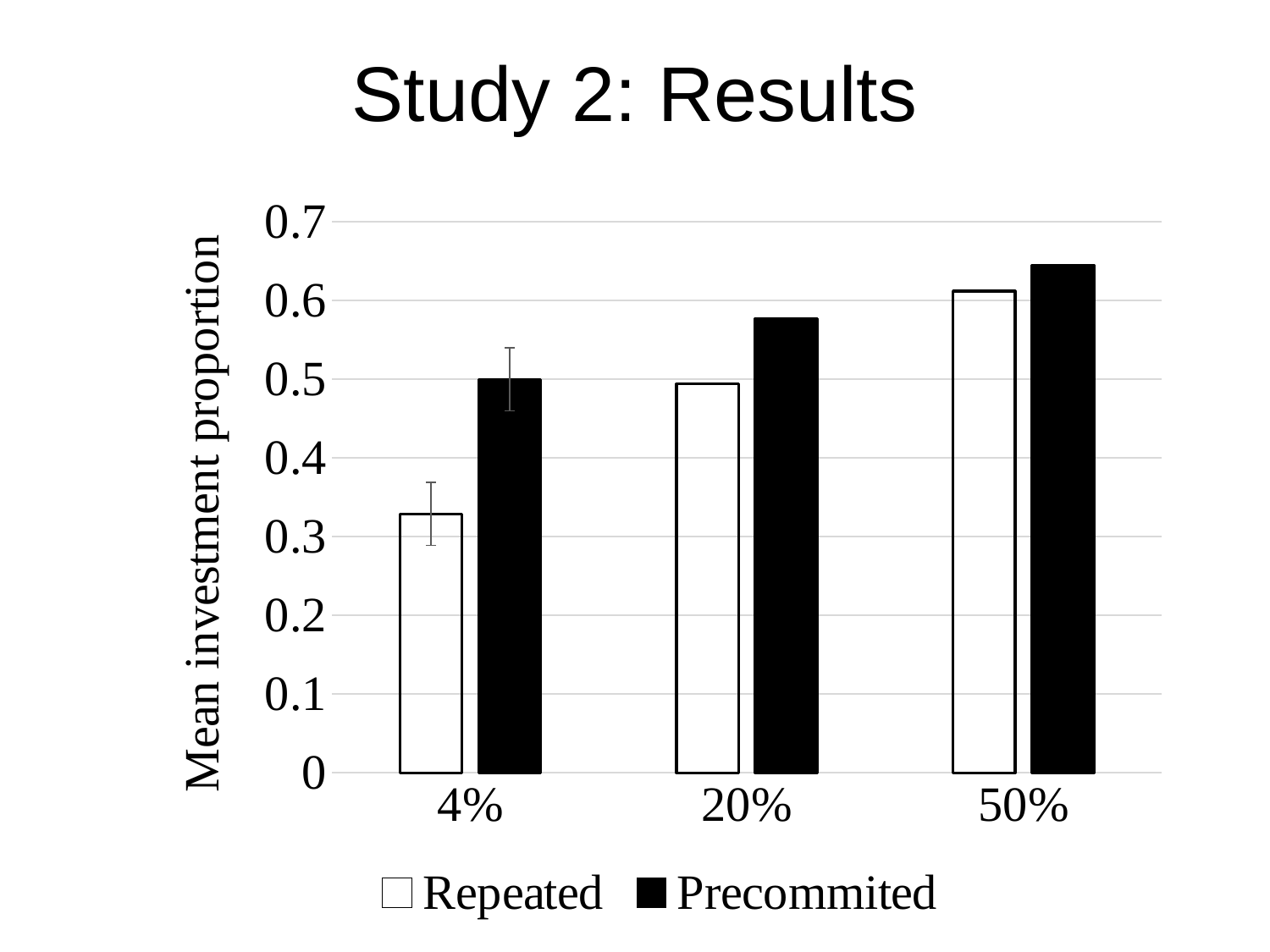
Is the value for Precommited at 20% greater or less than 0.5? greater Which category and series has the lowest mean investment proportion? Repeated at 4% What is the title of the y axis? Mean investment proportion Is the value for Repeated at 4% greater or less than 0.4? less Do the Repeated values rise or fall as the x-axis moves from 4% to 50%? rise Is the value for Precommited at 50% greater or less than 0.6? greater How many series does the legend list? 2 What kind of chart is shown on the slide? bar chart Which category and series has the highest mean investment proportion? Precommited at 50% At 20%, which series has the larger value, Repeated or Precommited? Precommited How many categories are shown on the x axis? 3 At 4%, which series has the larger value, Repeated or Precommited? Precommited